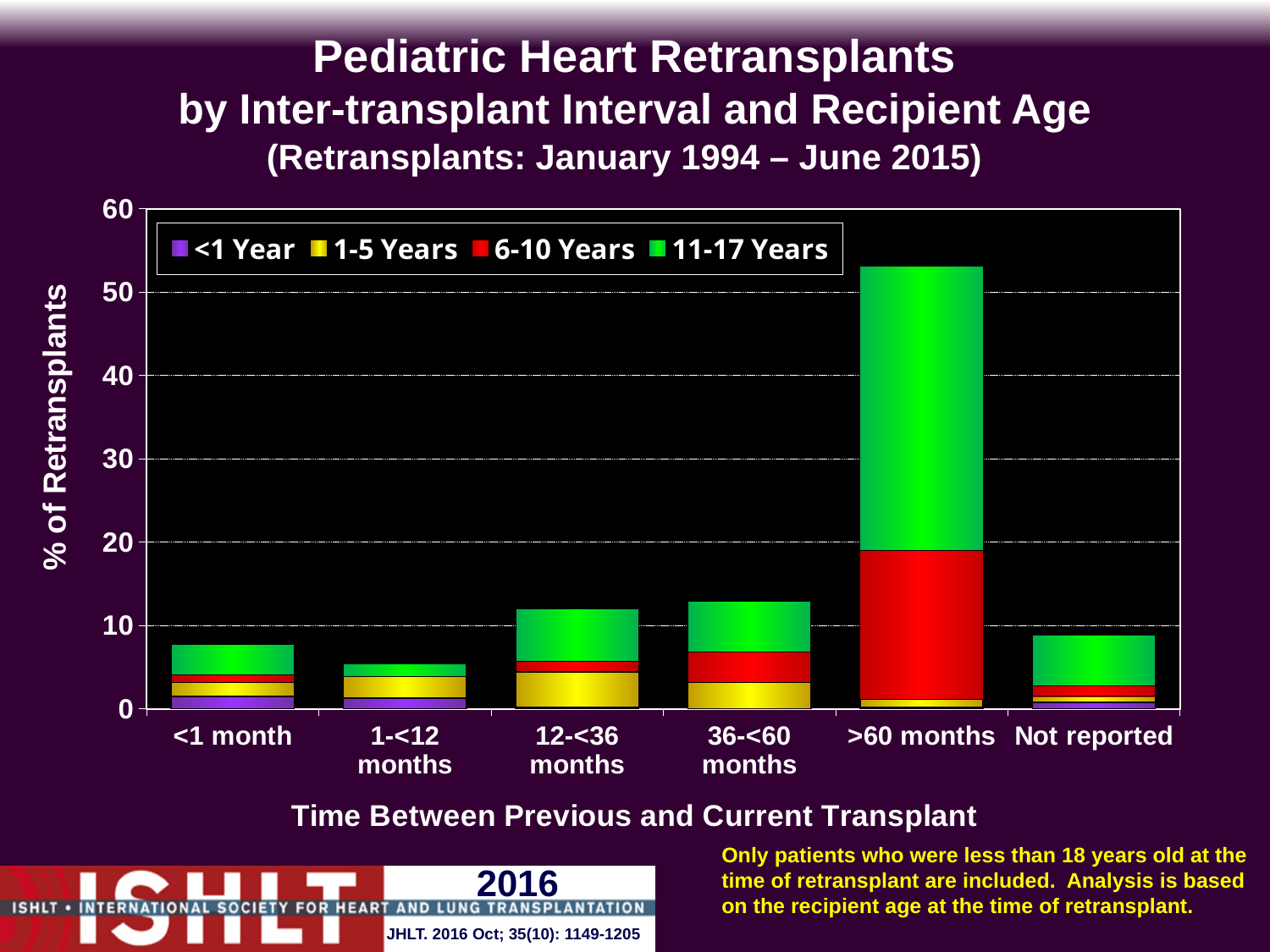
Is the total value for 12-<36 months greater or less than 10? greater Is the total value for Not reported greater or less than 10? less Which inter-transplant interval has the lowest total percentage of retransplants? 1-<12 months Which has a larger total percentage of retransplants, 36-<60 months or Not reported? 36-<60 months Which colour represents the 11-17 Years age group in the legend? green Which inter-transplant interval has the highest total percentage of retransplants? >60 months What is the label of the y axis? % of Retransplants What kind of chart is shown on the slide? stacked bar chart How many recipient age groups does the legend list? 4 Is the total value for >60 months greater or less than 50? greater How many inter-transplant interval categories are shown on the x axis? 6